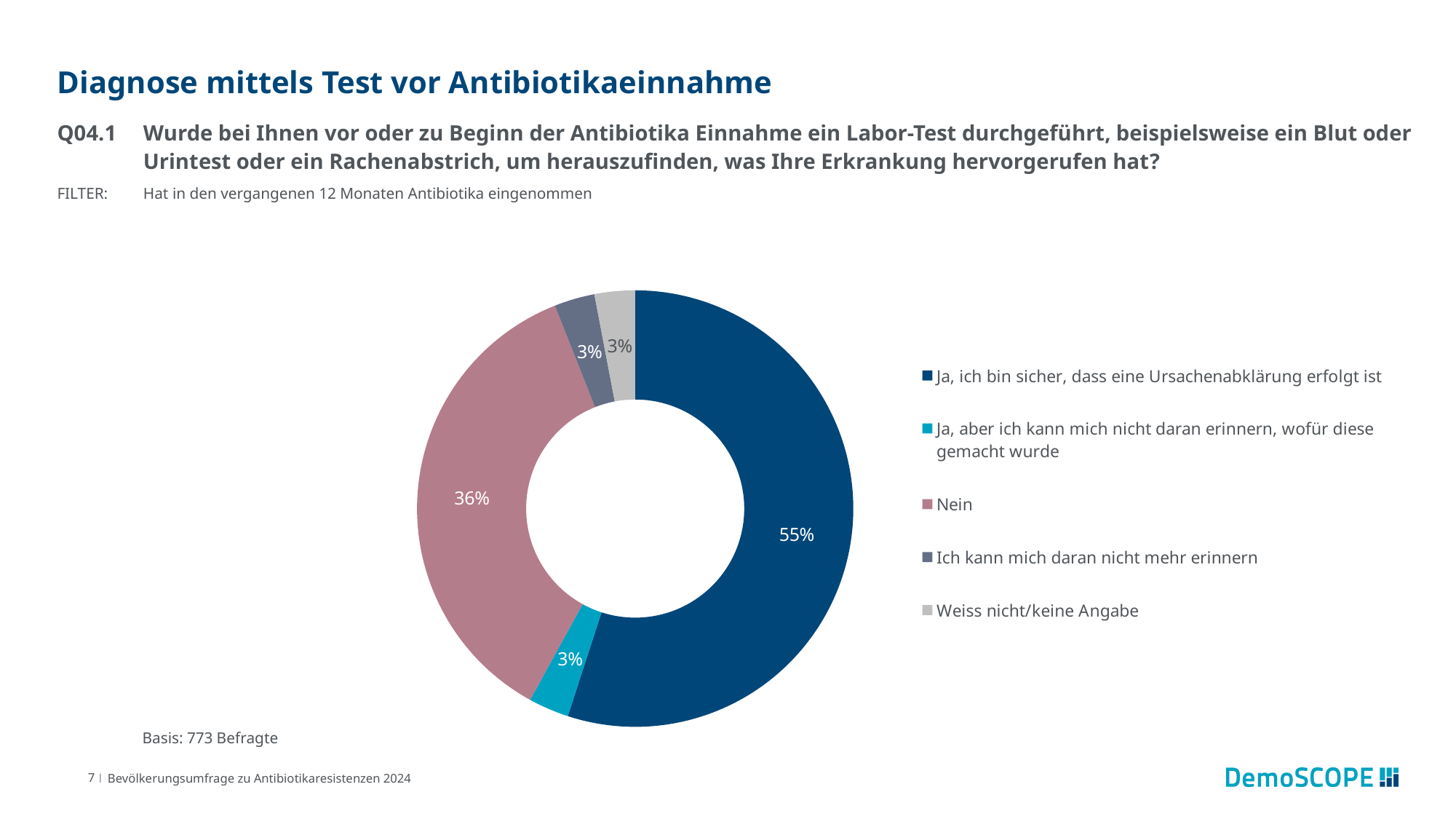
What is the difference in percentage points between the "Ja, ich bin sicher, dass eine Ursachenabklärung erfolgt ist" slice and the "Nein" slice? 19 percentage points What kind of chart is shown on the slide? Pie chart (donut) How many answer categories does the legend list? 5 What share of respondents answered "Ja, ich bin sicher, dass eine Ursachenabklärung erfolgt ist"? 55% Which is larger: the share for "Nein" or the share for "Ich kann mich daran nicht mehr erinnern"? Nein What share of respondents answered "Ja, aber ich kann mich nicht daran erinnern, wofür diese gemacht wurde"? 3% What is the basis (number of respondents) stated below the chart? 773 Befragte What share of respondents answered "Nein"? 36% Which colour represents the "Nein" category in the chart? Mauve/pink What is the combined share of the two "Ja" answers? 58% Which answer category has the largest share of the pie? Ja, ich bin sicher, dass eine Ursachenabklärung erfolgt ist What share of respondents answered "Weiss nicht/keine Angabe"? 3%